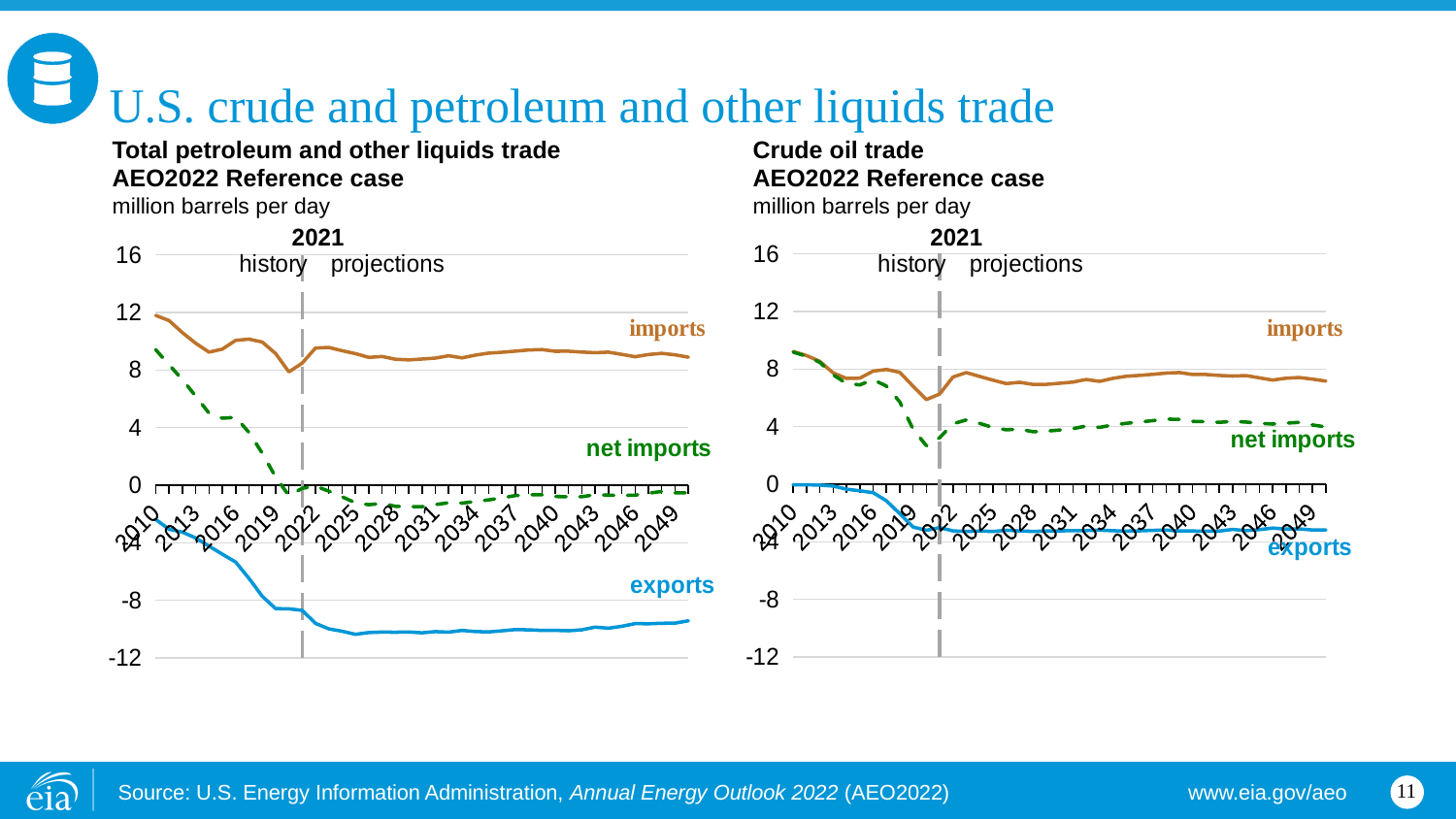
In the 'Total petroleum and other liquids trade' chart, is the value for imports in 2049 greater or less than 8? greater In the 'Crude oil trade' chart, is the value for net imports in 2021 greater or less than 4? less In the 'Crude oil trade' chart, do imports rise or fall between 2010 and 2021? fall In the 'Total petroleum and other liquids trade' chart, is the value for exports in 2049 greater or less than -8? less What unit is used on the y axis of both charts? million barrels per day How many series are plotted in the 'Crude oil trade' chart? 3 What type of chart is the 'Total petroleum and other liquids trade' chart? line chart Which year marks the boundary between history and projections in both charts? 2021 In the 'Total petroleum and other liquids trade' chart, do exports rise or fall between 2010 and 2021? fall